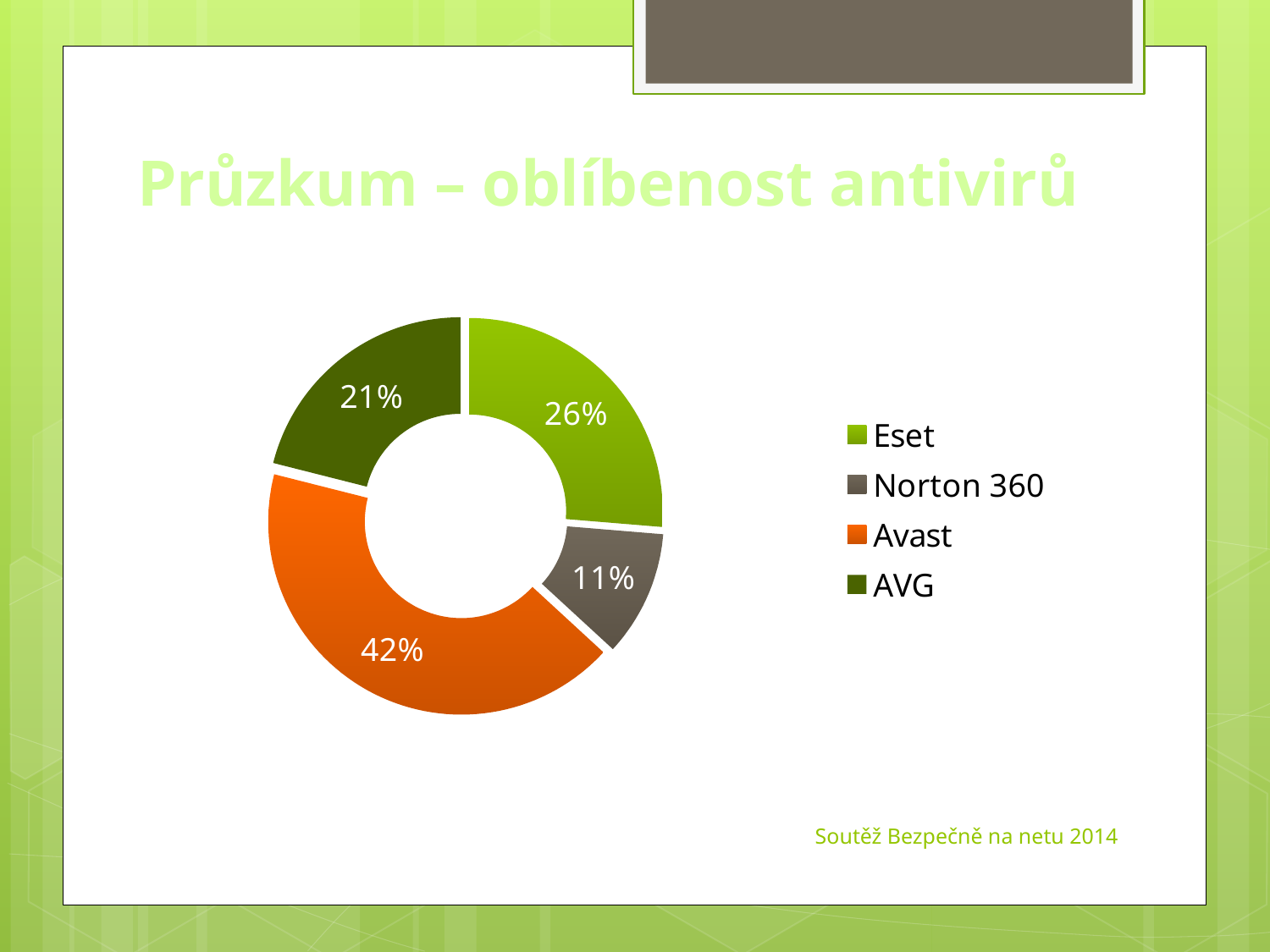
What share of the doughnut chart does Avast have? 42% Which has a larger share, Eset or AVG? Eset What percentage is shown for Eset? 26% What percentage is shown for Norton 360? 11% What colour represents Avast in the chart? Orange How many categories does the chart show? 4 What is the difference in percentage points between AVG and Norton 360? 10 What is the difference in percentage points between Avast and Eset? 16 What type of chart is shown on the slide? Doughnut chart Which antivirus has the smallest share in the chart? Norton 360 Which antivirus has the largest share in the chart? Avast What percentage is shown for AVG? 21%